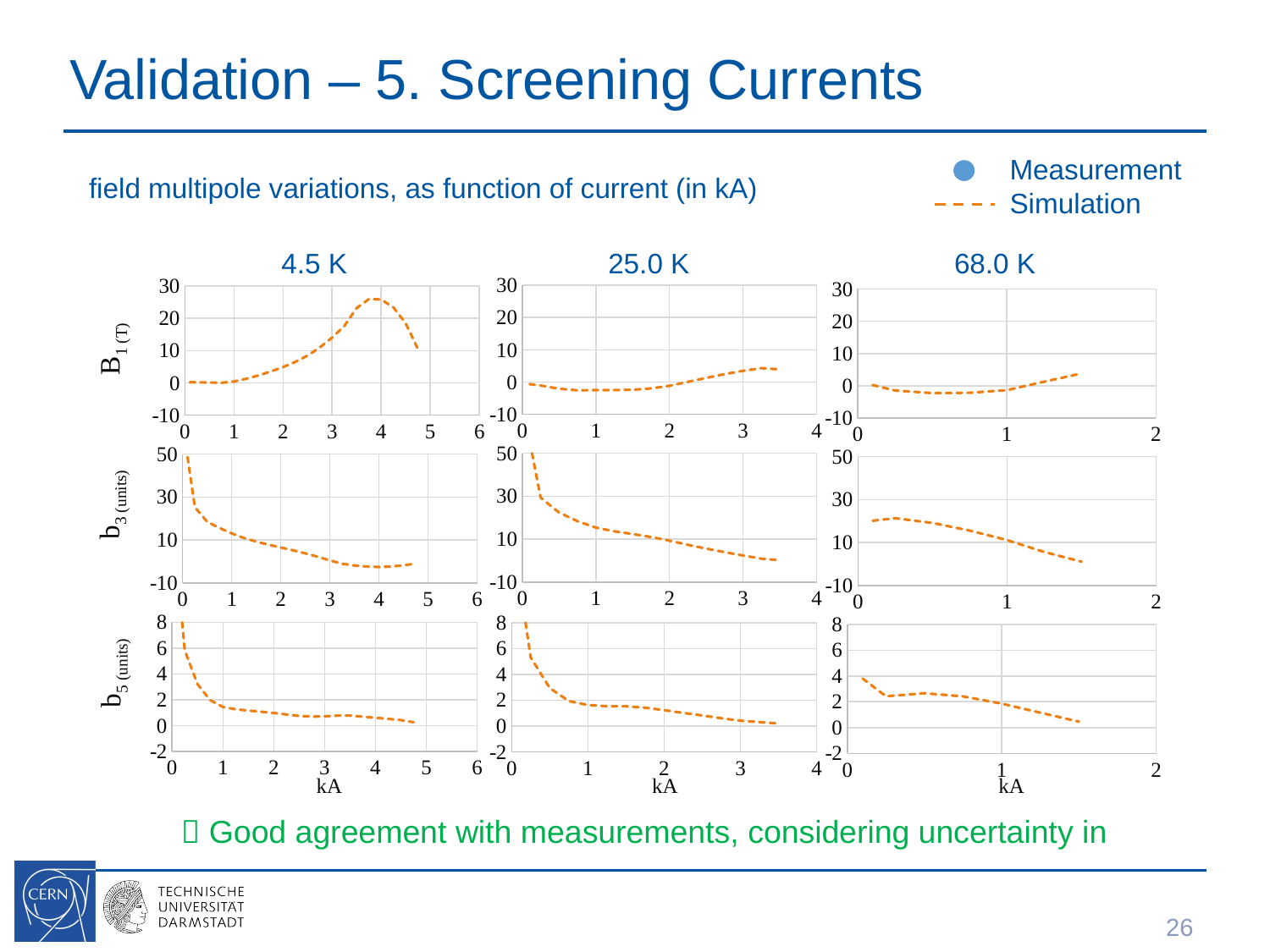
In the 4.5 K b5 chart, does the simulation curve rise or fall as current increases? fall What are the two entries in the legend? Measurement, Simulation What kind of chart is used in the 4.5 K B1 panel? line chart In the 68.0 K b3 chart, is the simulation value near 0 kA greater or less than 10? greater In the 68.0 K b5 chart, is the simulation value at 1.5 kA greater or less than 2? less How many chart panels are shown on the slide? 9 How many series does the legend list? 2 In the 4.5 K B1 chart, is the peak value of the simulation curve greater or less than 20? greater What unit is shown on the x axis of the bottom row of charts? kA In the 25.0 K b3 chart, does the simulation curve rise or fall as current increases? fall